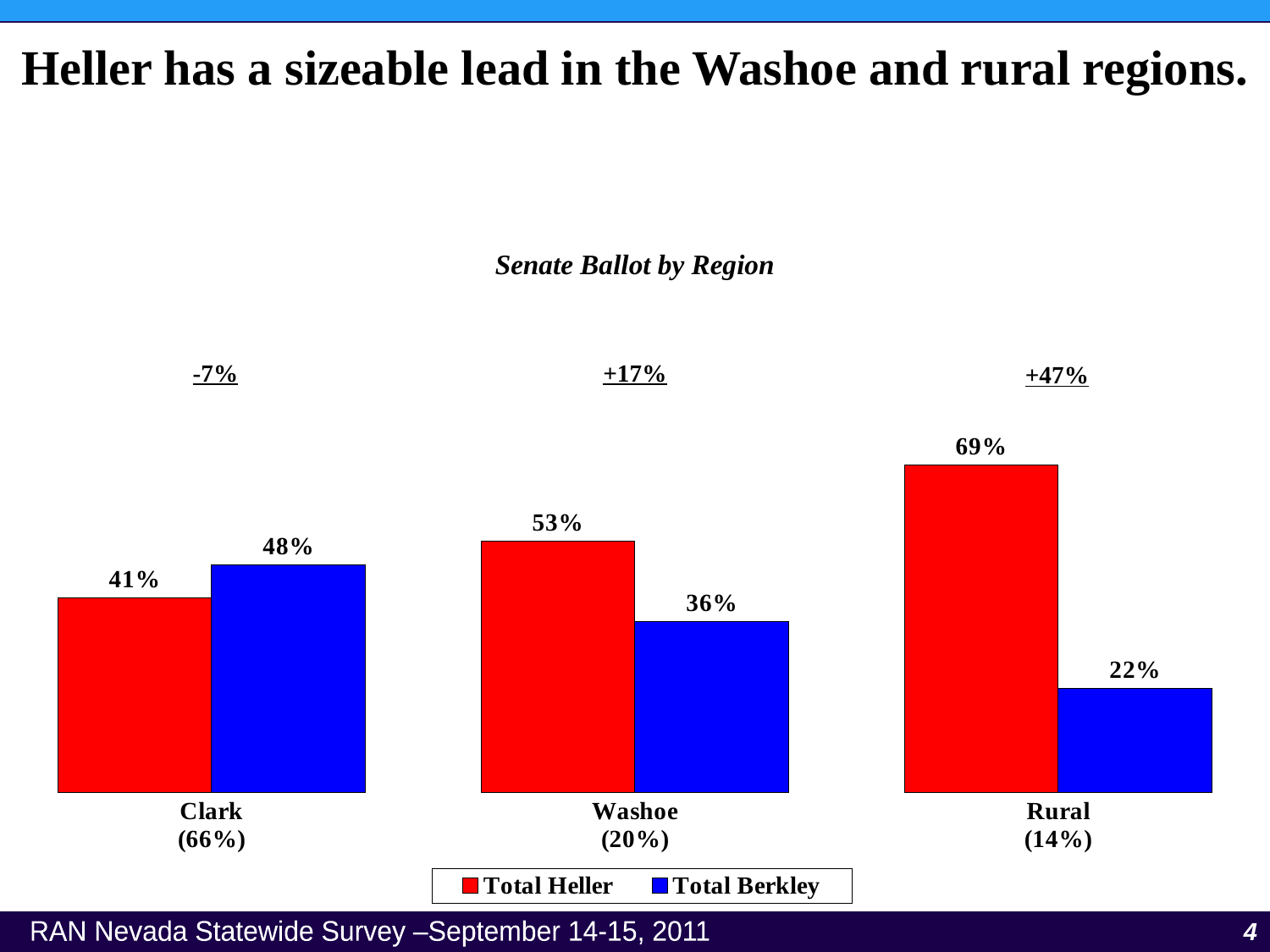
What is the difference between Total Heller and Total Berkley in the Washoe region? 17% How many regions are shown on the x axis? 3 In the Clark region, which is larger: Total Heller or Total Berkley? Total Berkley What kind of chart is shown on the slide? Bar chart What is the value for Total Berkley in the Rural region? 22% What is the value for Total Heller in the Clark region? 41% What is the title of the chart? Senate Ballot by Region In which region is the Total Berkley value lowest? Rural In which region is the Total Heller value highest? Rural What is the value for Total Berkley in the Washoe region? 36% How many series does the legend list? 2 What is the value for Total Heller in the Rural region? 69%